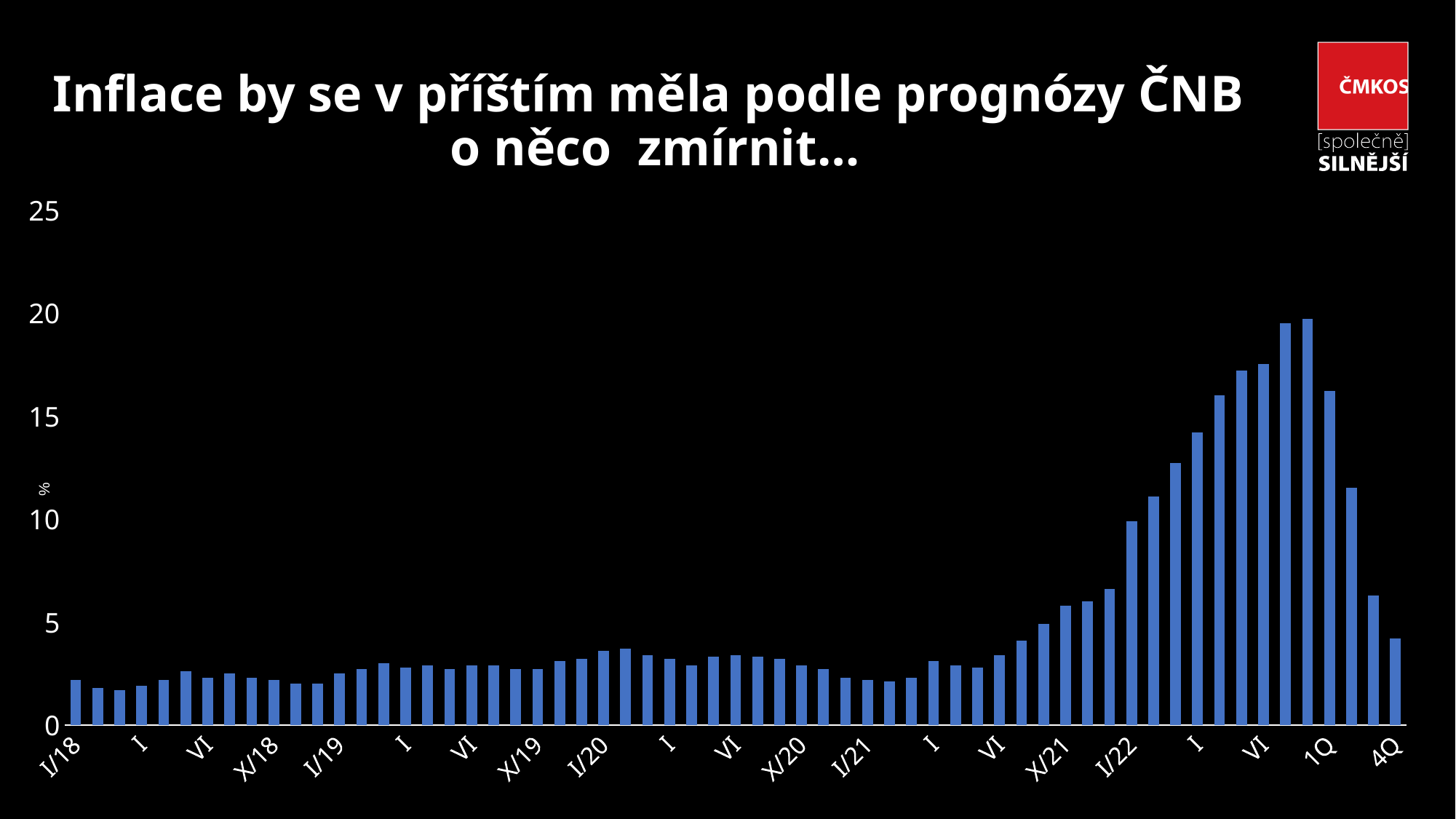
Is the value for 4Q greater or less than 5? less What is the title of the chart on the slide? Inflace by se v příštím měla podle prognózy ČNB o něco zmírnit… Is the highest bar in the chart greater or less than 15? greater What unit is shown on the vertical axis of the chart? % Do the values rise or fall from the highest bar to the last bar (4Q)? fall Is the value for I/18 greater or less than 5? less What kind of chart is shown on the slide? bar chart Which is larger, the value for I/22 or the value for I/18? I/22 Which is larger, the value for 4Q or the value for I/18? 4Q